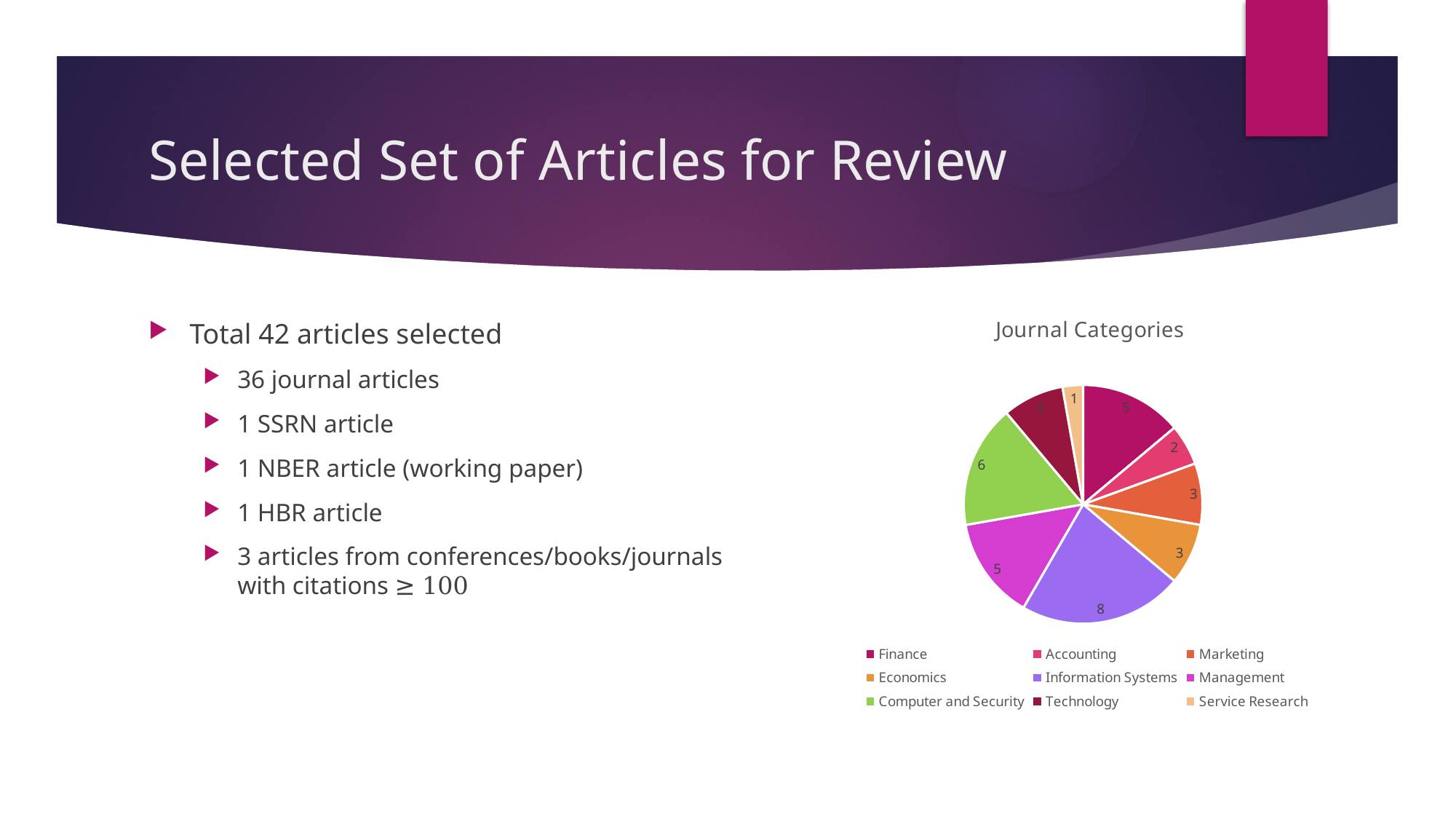
What value is shown for the Computer and Security slice in the Journal Categories pie chart? 6 In the Journal Categories pie chart, what is the difference between the Information Systems value and the Finance value? 3 What type of chart is shown under the title "Journal Categories"? pie chart How many categories does the legend of the Journal Categories pie chart list? 9 Which category has the smallest slice in the Journal Categories pie chart? Service Research What is the title of the pie chart on the slide? Journal Categories Which category has the largest slice in the Journal Categories pie chart? Information Systems What is the total of all slice values in the Journal Categories pie chart? 36 How many articles are in the Information Systems slice of the Journal Categories pie chart? 8 What value is shown for the Accounting slice in the Journal Categories pie chart? 2 What value is shown for the Service Research slice in the Journal Categories pie chart? 1 In the Journal Categories pie chart, which is larger: Computer and Security or Management? Computer and Security